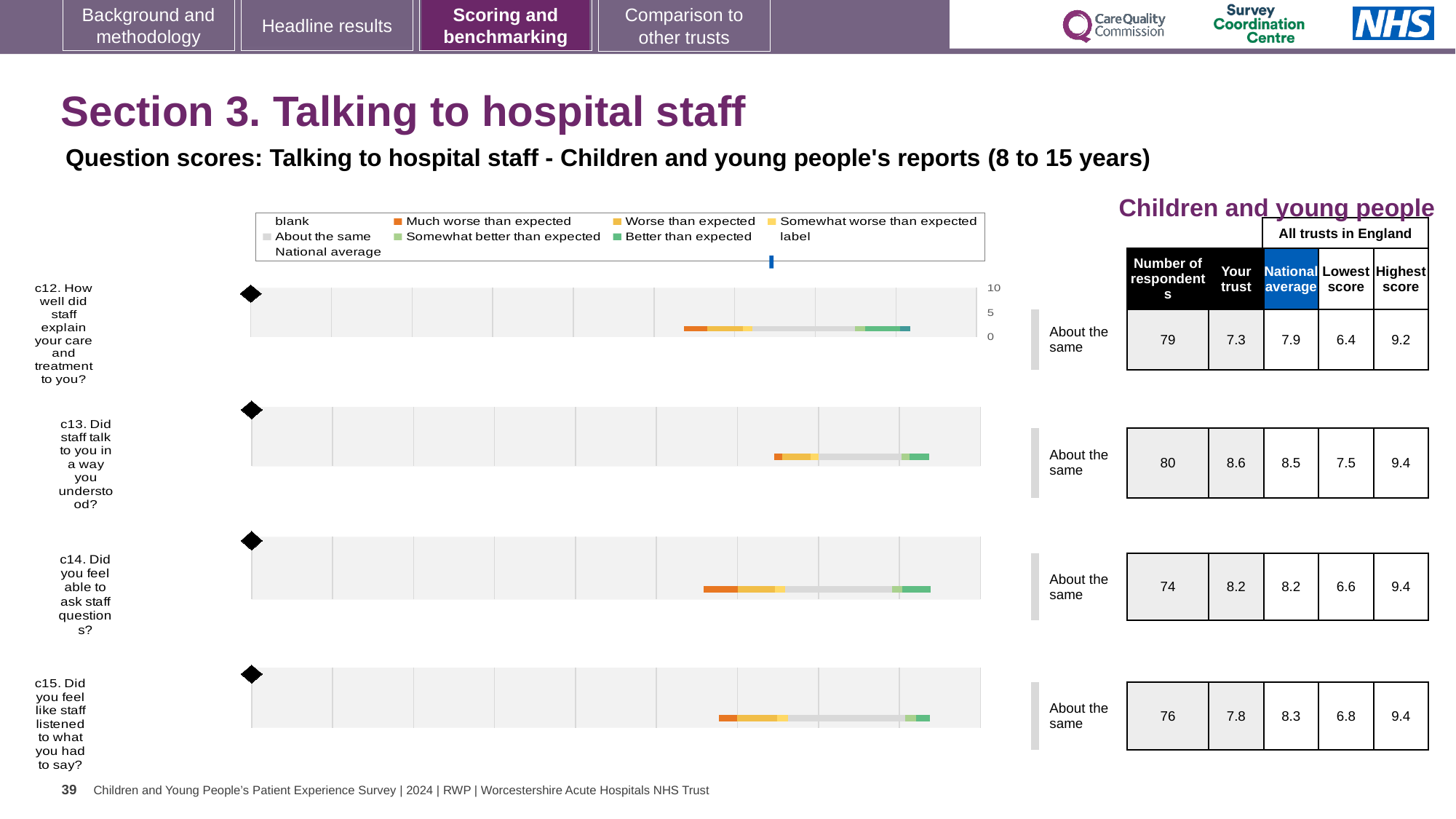
For c12, what is the difference between the national average and the 'Your trust' score? 0.6 How many entries does the legend above the charts list? 9 What is the national average shown for c15 (Did you feel like staff listened to what you had to say)? 8.3 What is the highest score across all trusts in England shown for c12? 9.2 Which question has the lowest 'Your trust' score? c12 What benchmark label is shown next to the chart for c14? About the same What kind of chart is used to show the question scores for c12 to c15? bar chart How many respondents are shown for c14 (Did you feel able to ask staff questions)? 74 How many questions (c12 to c15) have a chart on this slide? 4 What is the 'Your trust' score shown for c13 (Did staff talk to you in a way you understood)? 8.6 Which question has the highest 'Your trust' score? c13 For c15, which is larger: the 'Your trust' score or the national average? National average